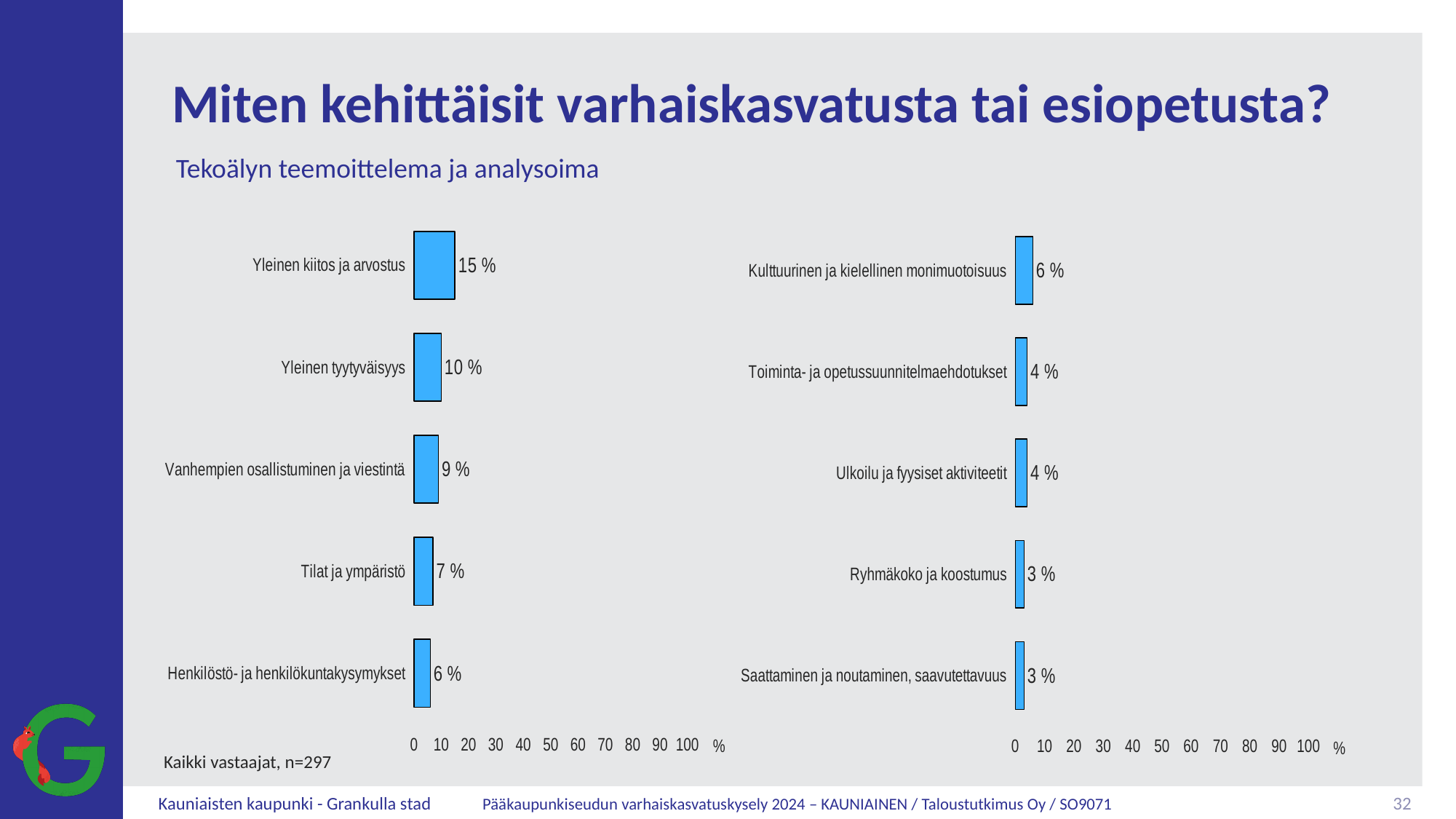
In the left chart, what is the value for Yleinen kiitos ja arvostus? 15 % In the left chart, which category has the lowest value? Henkilöstö- ja henkilökuntakysymykset In the left chart, which category has the highest value? Yleinen kiitos ja arvostus How many categories are shown in the right chart? 5 In the right chart, what is the value for Ryhmäkoko ja koostumus? 3 % In the left chart, what is the value for Tilat ja ympäristö? 7 % In the left chart, what is the difference between Yleinen kiitos ja arvostus and Yleinen tyytyväisyys? 5 % In the right chart, what is the difference between Kulttuurinen ja kielellinen monimuotoisuus and Toiminta- ja opetussuunnitelmaehdotukset? 2 % In the right chart, which category has the highest value? Kulttuurinen ja kielellinen monimuotoisuus In the left chart, which is larger: Vanhempien osallistuminen ja viestintä or Tilat ja ympäristö? Vanhempien osallistuminen ja viestintä In the right chart, what is the value for Kulttuurinen ja kielellinen monimuotoisuus? 6 % What kind of chart is the left chart? Bar chart